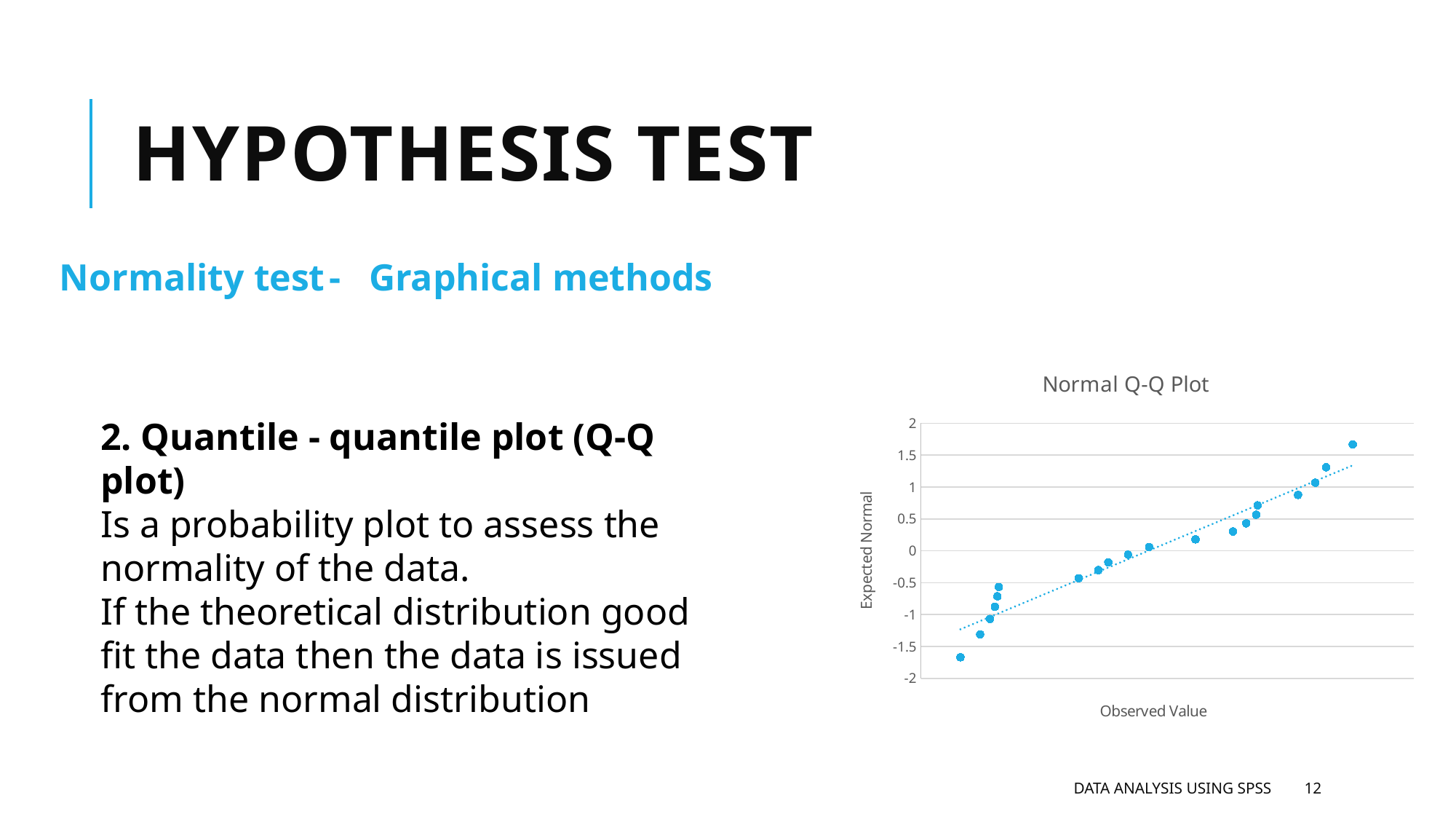
In the Normal Q-Q Plot, is the Expected Normal value of the lowest point greater or less than -1.5? less In the Normal Q-Q Plot, do the points rise or fall as the Observed Value increases along the x axis? rise What kind of chart is the Normal Q-Q Plot on the slide? scatter plot What is the label of the vertical axis of the Normal Q-Q Plot? Expected Normal In the Normal Q-Q Plot, is the Expected Normal value of the highest point greater or less than 2? less What is the lowest tick value shown on the vertical axis of the Normal Q-Q Plot? -2 What is the highest tick value shown on the vertical axis of the Normal Q-Q Plot? 2 What is the title of the chart on the slide? Normal Q-Q Plot In the Normal Q-Q Plot, is the Expected Normal value of the lowest point greater or less than -2? greater